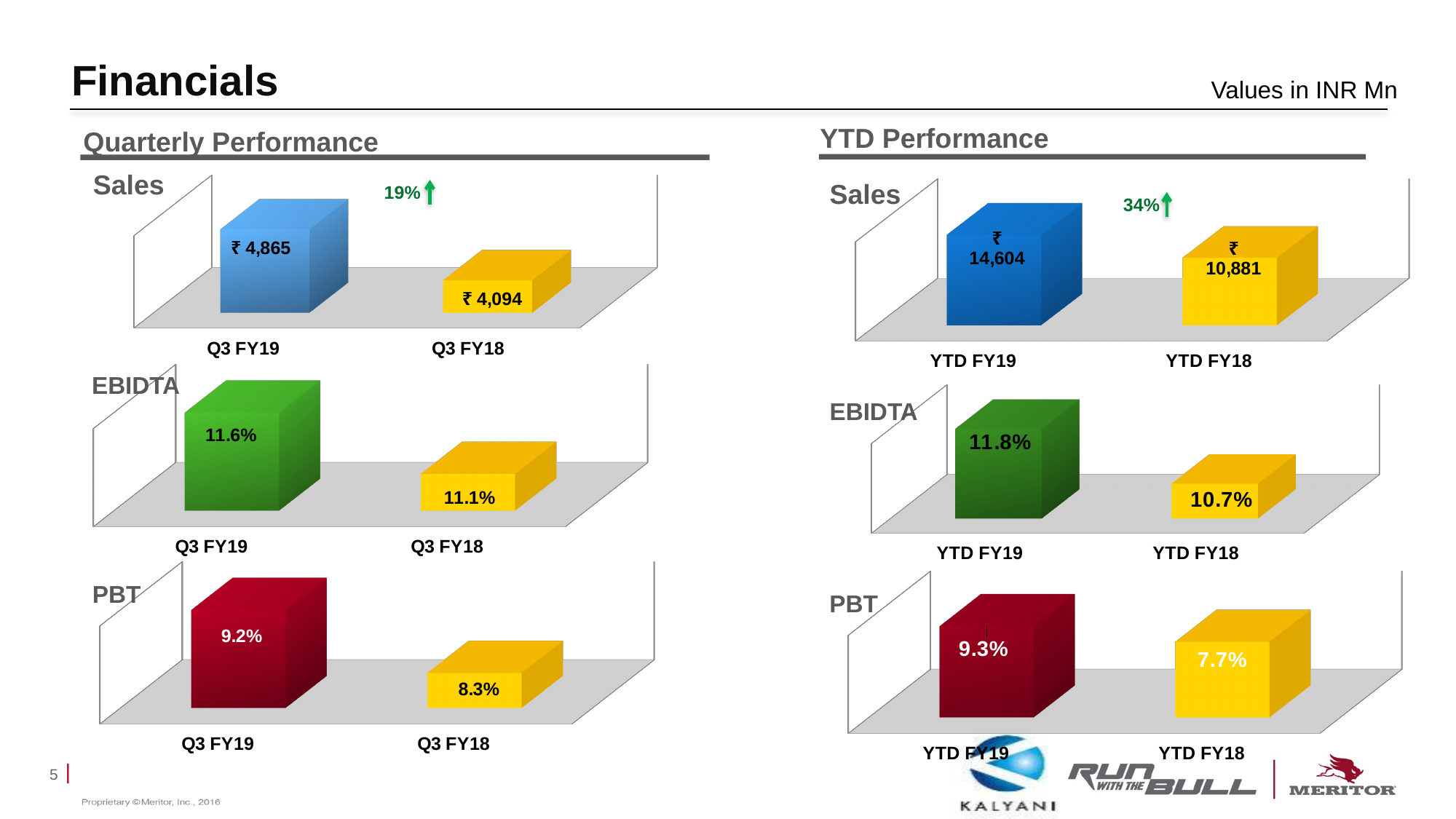
In the Quarterly Performance Sales chart, what is the value for Q3 FY18? ₹ 4,094 How many categories are shown in the Quarterly Performance Sales chart? 2 In the YTD Performance PBT chart, what is the value for YTD FY18? 7.7% In the Quarterly Performance PBT chart, what is the difference between Q3 FY19 and Q3 FY18? 0.9% In the Quarterly Performance EBIDTA chart, what is the value for Q3 FY18? 11.1% In the YTD Performance Sales chart, what is the value for YTD FY19? ₹ 14,604 In the Quarterly Performance EBIDTA chart, which period has the higher value, Q3 FY19 or Q3 FY18? Q3 FY19 In the Quarterly Performance Sales chart, what is the value for Q3 FY19? ₹ 4,865 In the YTD Performance EBIDTA chart, what is the value for YTD FY19? 11.8% In the YTD Performance Sales chart, what is the difference between YTD FY19 and YTD FY18? ₹ 3,723 What type of chart is the YTD Performance Sales chart? Bar chart In the YTD Performance PBT chart, which period has the lowest value? YTD FY18